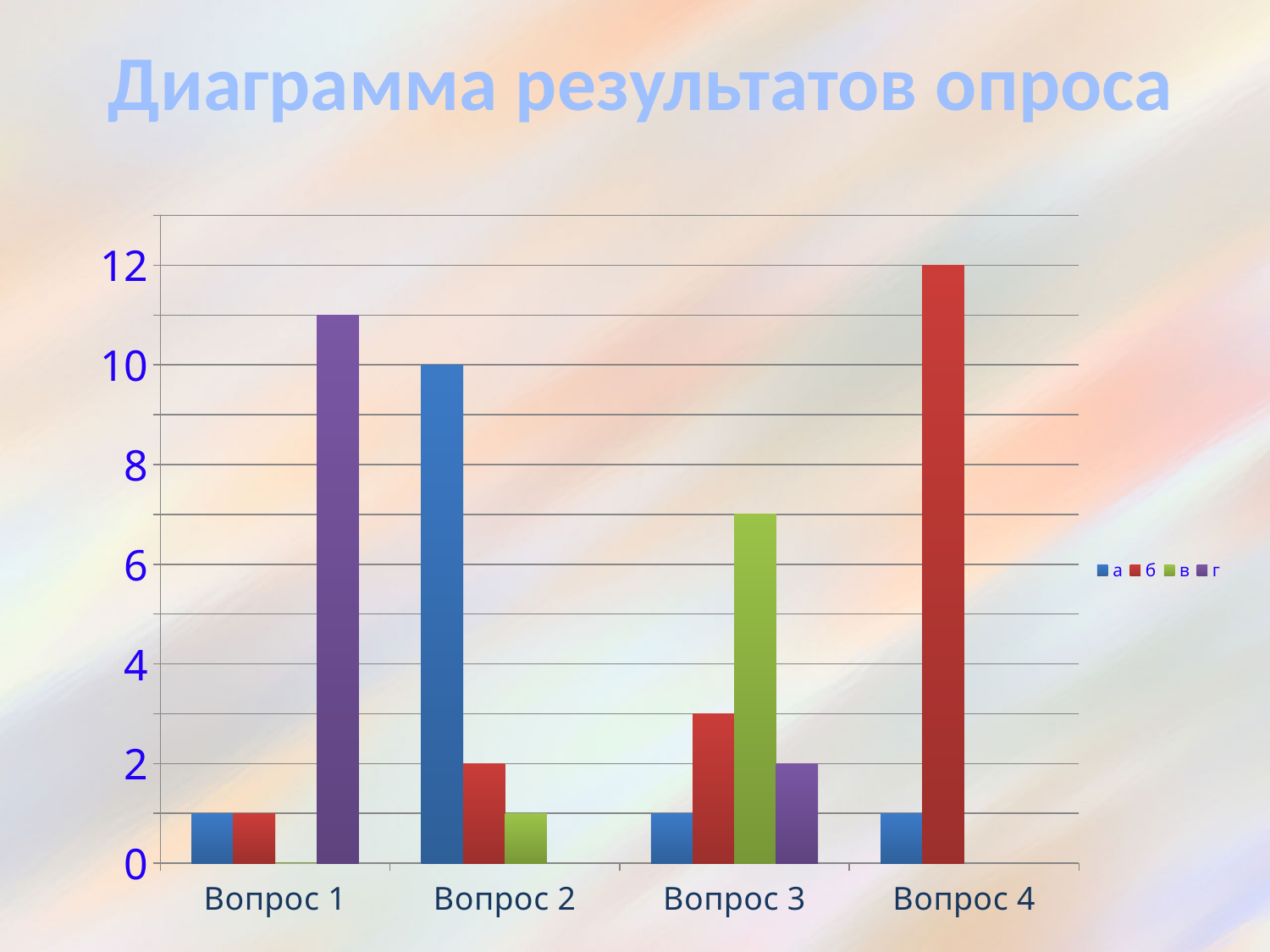
Is the value of series г for Вопрос 1 greater or less than 10? greater What is the title of the chart? Диаграмма результатов опроса What is the value of series а for Вопрос 2? 10 Which category contains the tallest bar in the chart? Вопрос 4 What type of chart is shown on the slide? bar chart Which series has the highest value for Вопрос 3? в What is the value of series б for Вопрос 2? 2 How many categories are shown on the x axis? 4 How many series does the legend list? 4 What is the value of series б for Вопрос 4? 12 What is the difference between series б for Вопрос 4 and series а for Вопрос 2? 2 Is the value of series в for Вопрос 3 greater or less than 6? greater